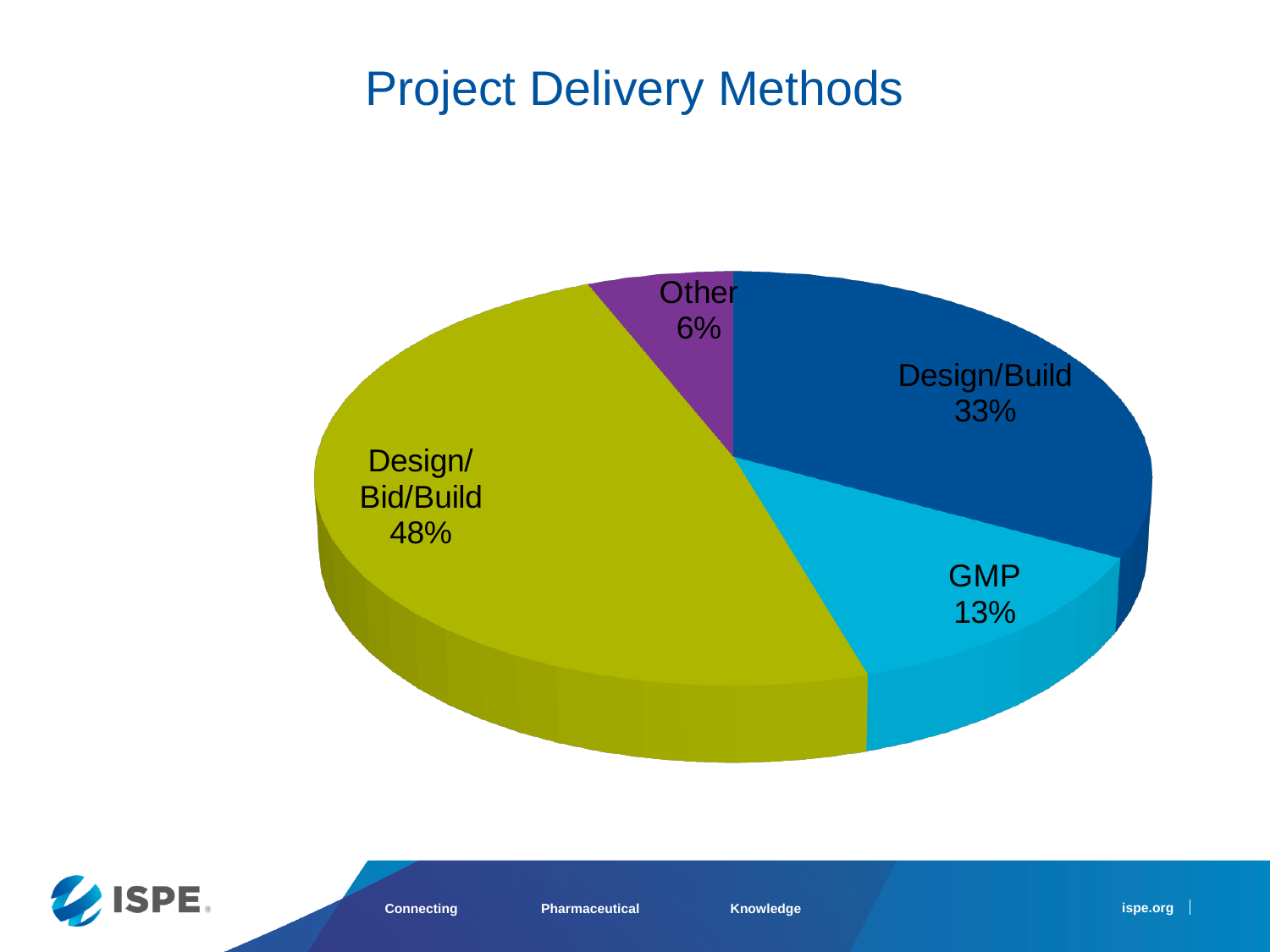
What share of the pie does GMP represent? 13% What share of the pie does Other represent? 6% What is the difference in percentage points between Design/Bid/Build and Design/Build? 15 Which has a larger share, GMP or Other? GMP What is the difference in percentage points between Design/Build and GMP? 20 What is the title of the chart? Project Delivery Methods Which project delivery method has the smallest share? Other What kind of chart is shown on the slide? Pie chart How many slices does the pie chart have? 4 What share of the pie does Design/Bid/Build represent? 48% What share of the pie does Design/Build represent? 33% Which project delivery method has the largest share? Design/Bid/Build